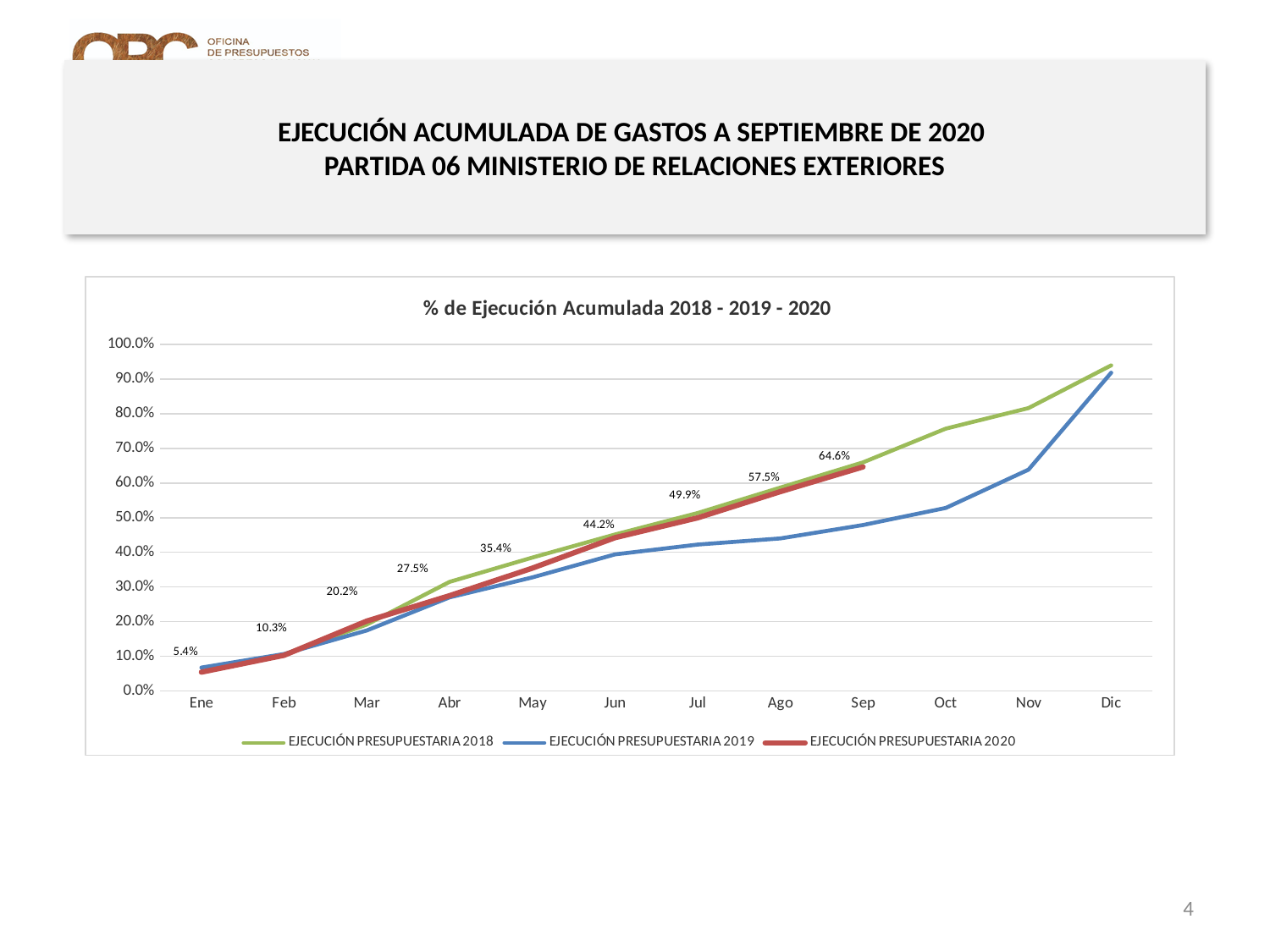
What is the value for EJECUCIÓN PRESUPUESTARIA 2020 in May? 35.4% What is the difference between the EJECUCIÓN PRESUPUESTARIA 2020 values for Sep and Ago? 7.1% In Oct, which series is higher: EJECUCIÓN PRESUPUESTARIA 2018 or EJECUCIÓN PRESUPUESTARIA 2019? EJECUCIÓN PRESUPUESTARIA 2018 What is the value for EJECUCIÓN PRESUPUESTARIA 2020 in Sep? 64.6% How many series does the legend list? 3 What type of chart is shown on the slide? line chart What is the value for EJECUCIÓN PRESUPUESTARIA 2020 in Ene? 5.4% Does the EJECUCIÓN PRESUPUESTARIA 2020 series rise or fall from Ene to Sep? rise What is the difference between the EJECUCIÓN PRESUPUESTARIA 2020 values for Jun and Mar? 24.0% What is the chart's title? % de Ejecución Acumulada 2018 - 2019 - 2020 How many months are shown on the x axis? 12 Is the value for EJECUCIÓN PRESUPUESTARIA 2019 in Nov greater or less than 70.0%? less